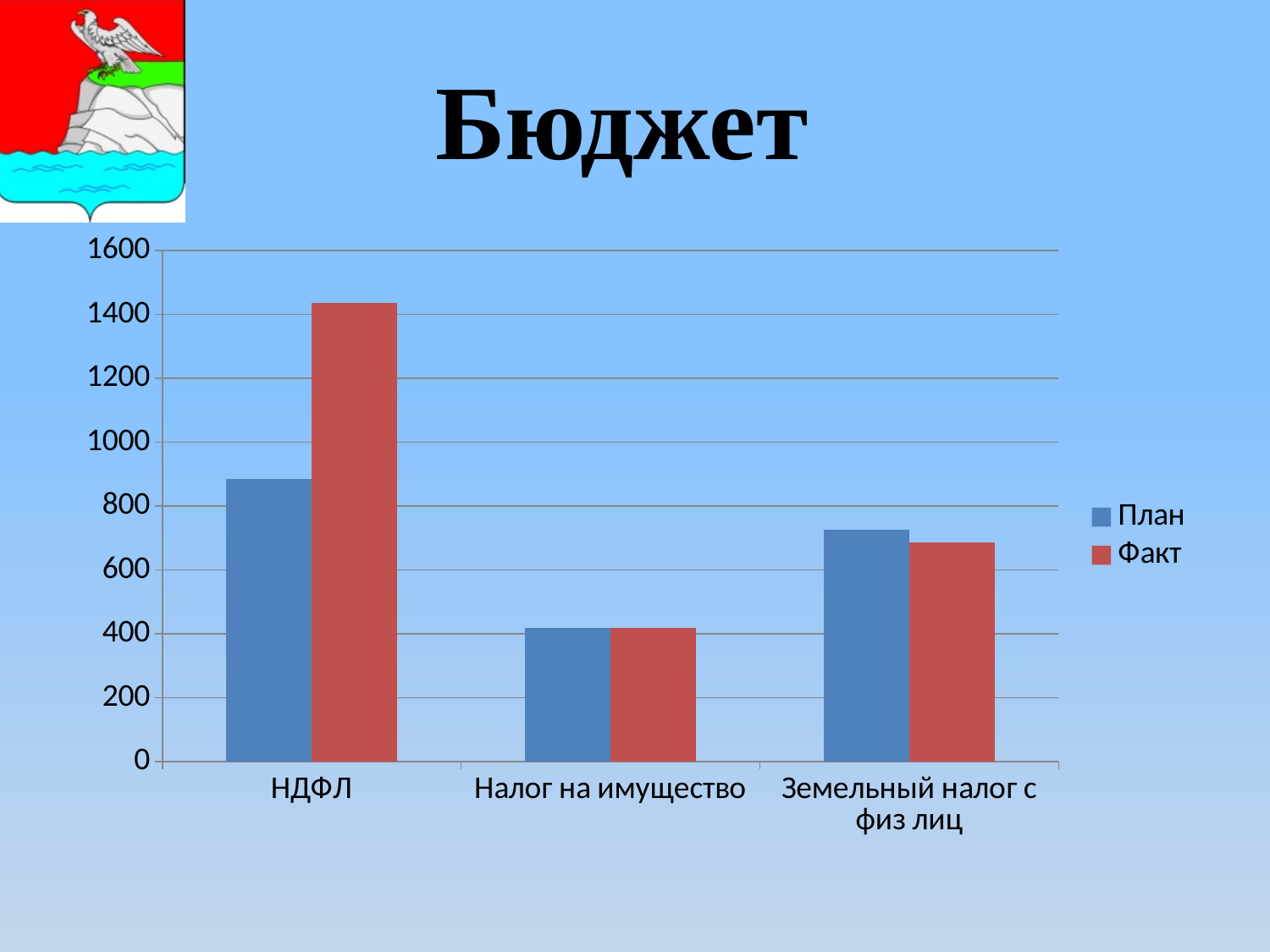
How many series does the legend list? 2 Which category has the highest Факт value? НДФЛ What is the title of the slide? Бюджет Which category has the lowest План value? Налог на имущество Is the План value for Налог на имущество greater or less than 600? less Is the План value for Земельный налог с физ лиц greater or less than 600? greater Is the Факт value for НДФЛ greater or less than 1200? greater What kind of chart is shown on the slide? bar chart How many categories are shown on the x axis of the chart? 3 For НДФЛ, which is larger: План or Факт? Факт What are the two series listed in the legend? План and Факт